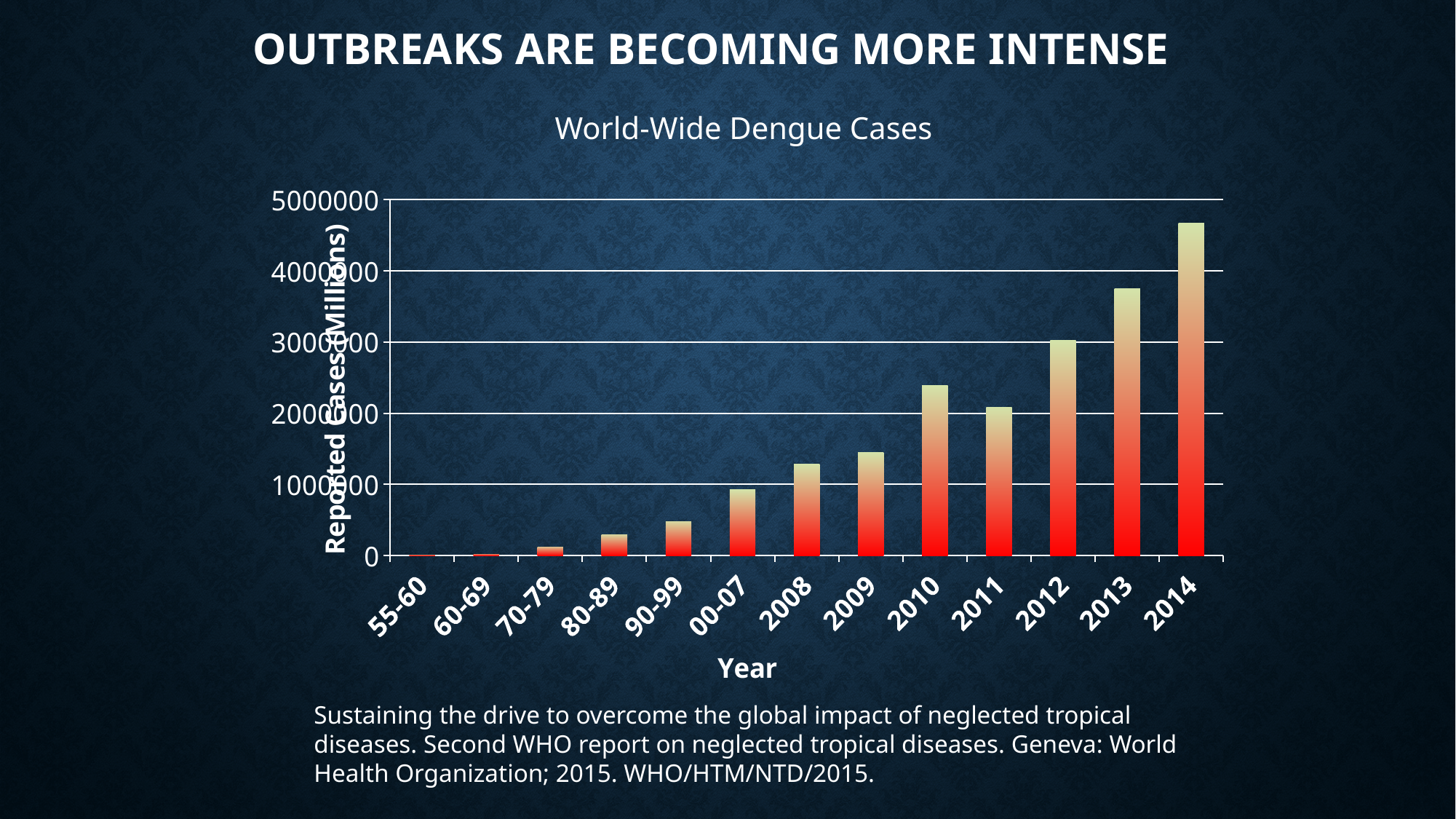
What is the label of the x axis? Year Which year has the highest number of reported dengue cases? 2014 Is the value for 2009 greater or less than 1000000? greater Which has more reported cases, 2010 or 2011? 2010 Is the value for 2014 greater or less than 4000000? greater What is the title of the chart? World-Wide Dengue Cases Is the value for 2013 greater or less than 4000000? less Do reported dengue cases generally rise or fall from 55-60 to 2014? Rise How many year categories are shown on the x axis? 13 What type of chart is shown on the slide? Bar chart